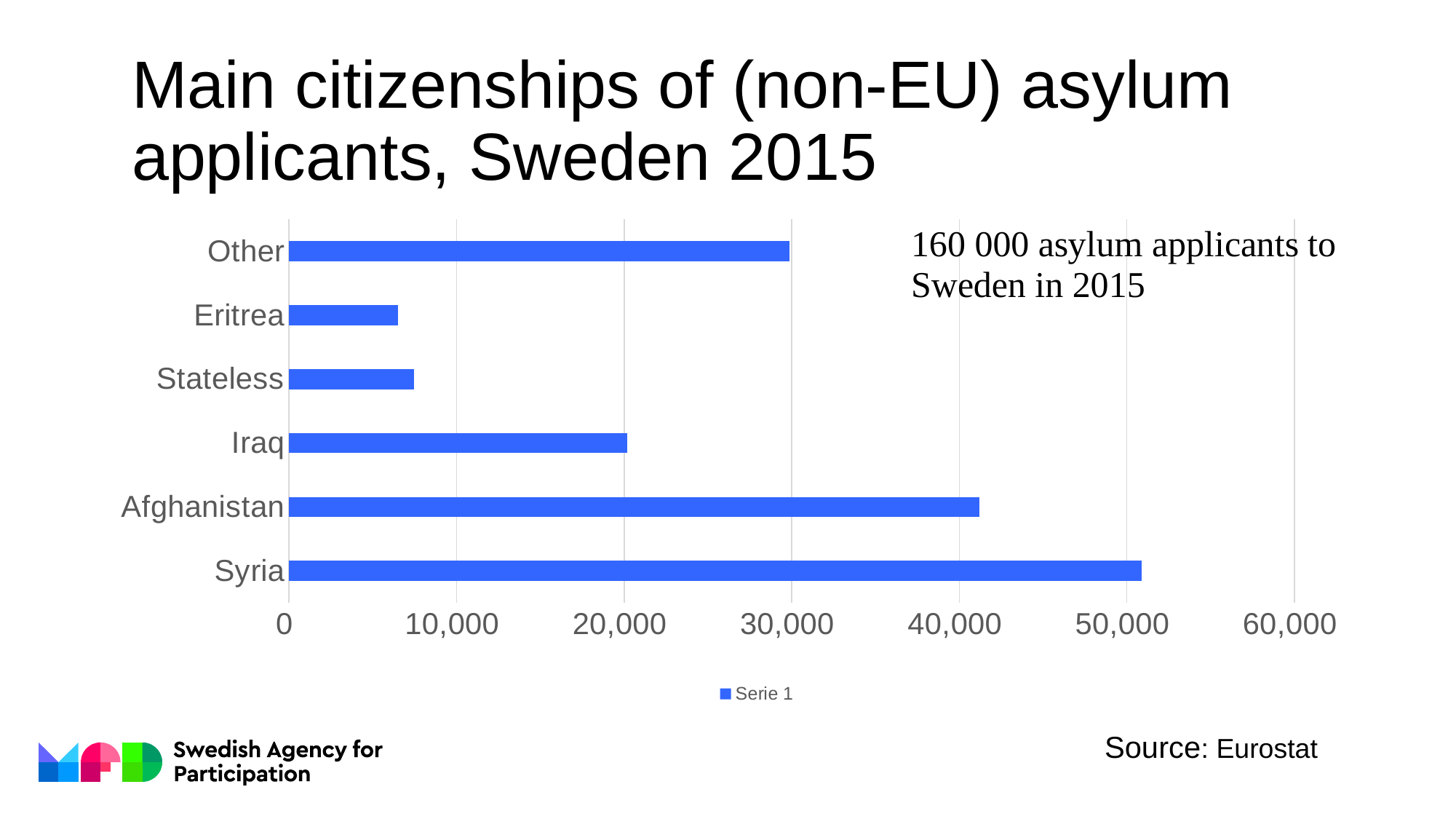
Which is larger, the value for Other or the value for Stateless? Other What kind of chart is shown on the slide? bar chart How many categories are plotted on the chart? 6 Is the value for Iraq greater or less than 30,000? less Is the value for Eritrea greater or less than 10,000? less Which category has the lowest value? Eritrea What is the name of the series shown in the legend? Serie 1 Which category has the highest value? Syria Is the value for Afghanistan greater or less than 40,000? greater How many series does the legend list? 1 Which is larger, the value for Afghanistan or the value for Iraq? Afghanistan